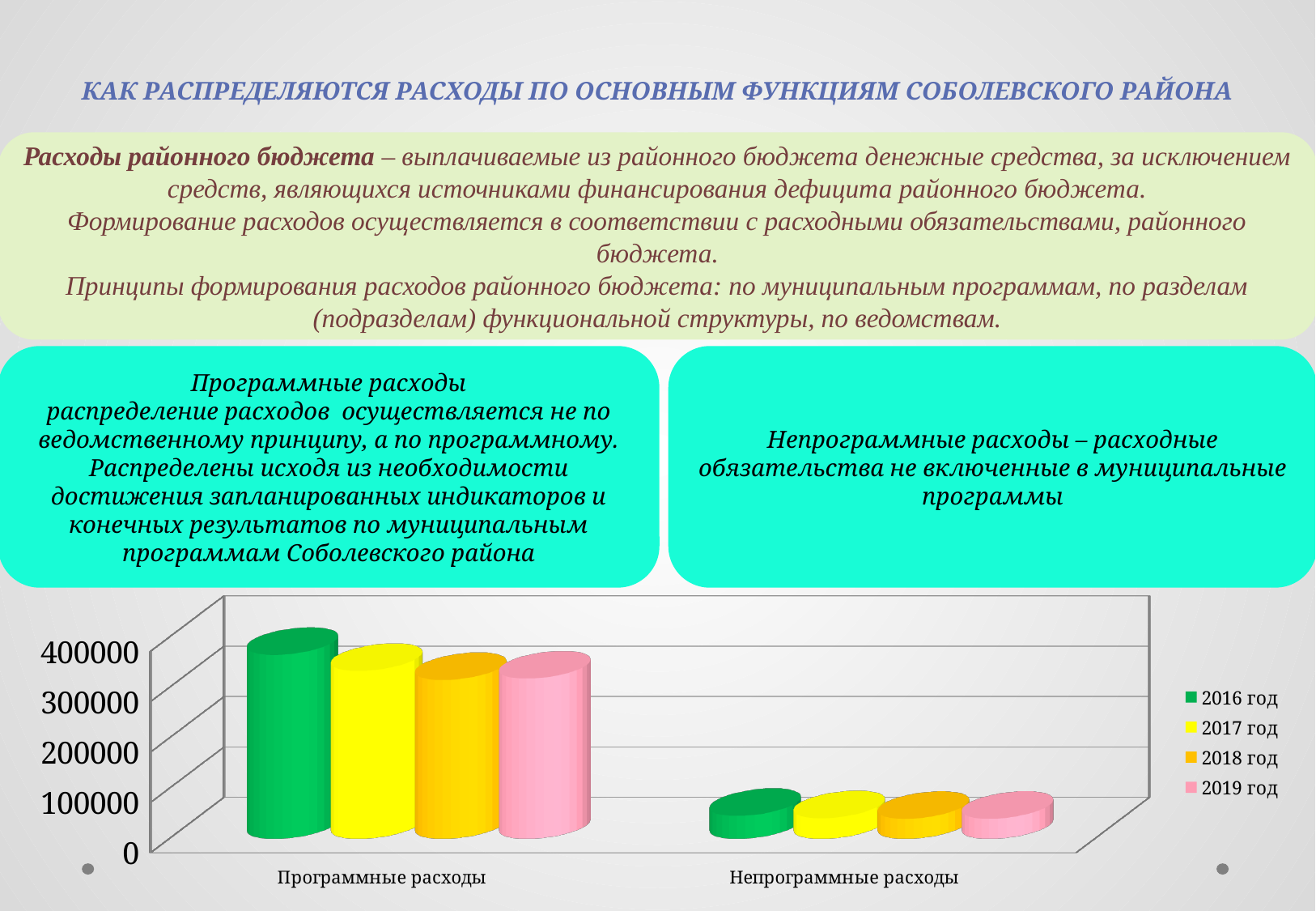
Which colour represents 2019 год in the chart's legend? pink Which series is shown in green in the chart? 2016 год How many series does the chart's legend list? 4 Is the value for Программные расходы in 2019 год greater or less than 200000? greater Which year has the highest value for Программные расходы? 2016 год Is the value for Непрограммные расходы in 2016 год greater or less than 100000? less Do the values for Программные расходы rise or fall from 2016 год to 2019 год? fall Which is larger in 2017 год: Программные расходы or Непрограммные расходы? Программные расходы Which is larger in 2019 год: Программные расходы or Непрограммные расходы? Программные расходы How many categories are shown on the x axis of the chart? 2 What kind of chart is shown on the slide? bar chart Is the value for Программные расходы in 2016 год greater or less than 300000? greater